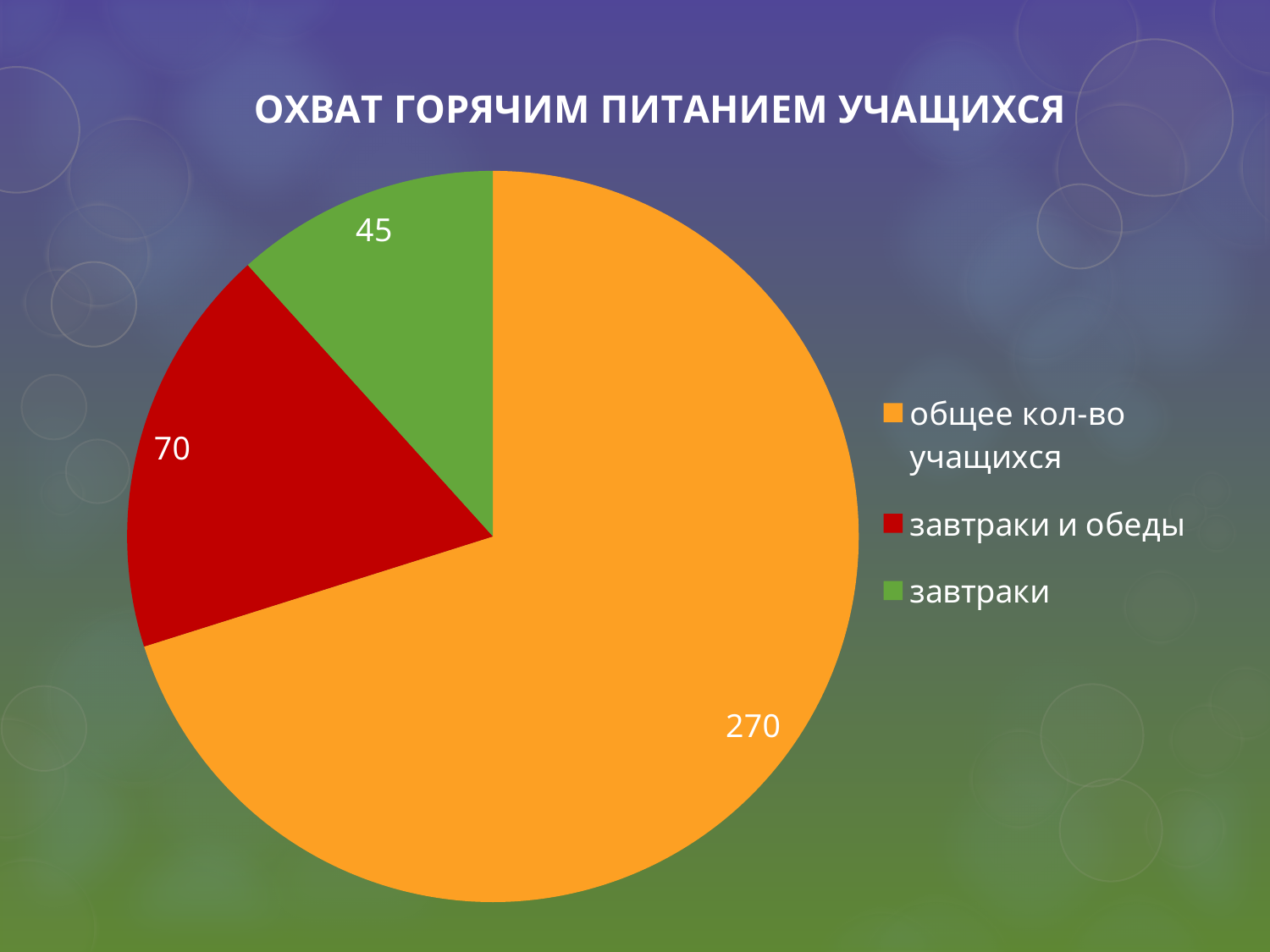
Which is larger, the value for "завтраки и обеды" or the value for "завтраки"? завтраки и обеды Which category has the largest slice? общее кол-во учащихся What is the difference between the values for "завтраки и обеды" and "завтраки"? 25 What is the difference between the values for "общее кол-во учащихся" and "завтраки и обеды"? 200 What colour is the slice for "завтраки"? green How many slices does the pie chart have? 3 What type of chart is shown on the slide? pie chart What is the title of the chart? ОХВАТ ГОРЯЧИМ ПИТАНИЕМ УЧАЩИХСЯ What is the value for "завтраки"? 45 Which category has the smallest slice? завтраки What is the value for "завтраки и обеды"? 70 What is the value for "общее кол-во учащихся"? 270